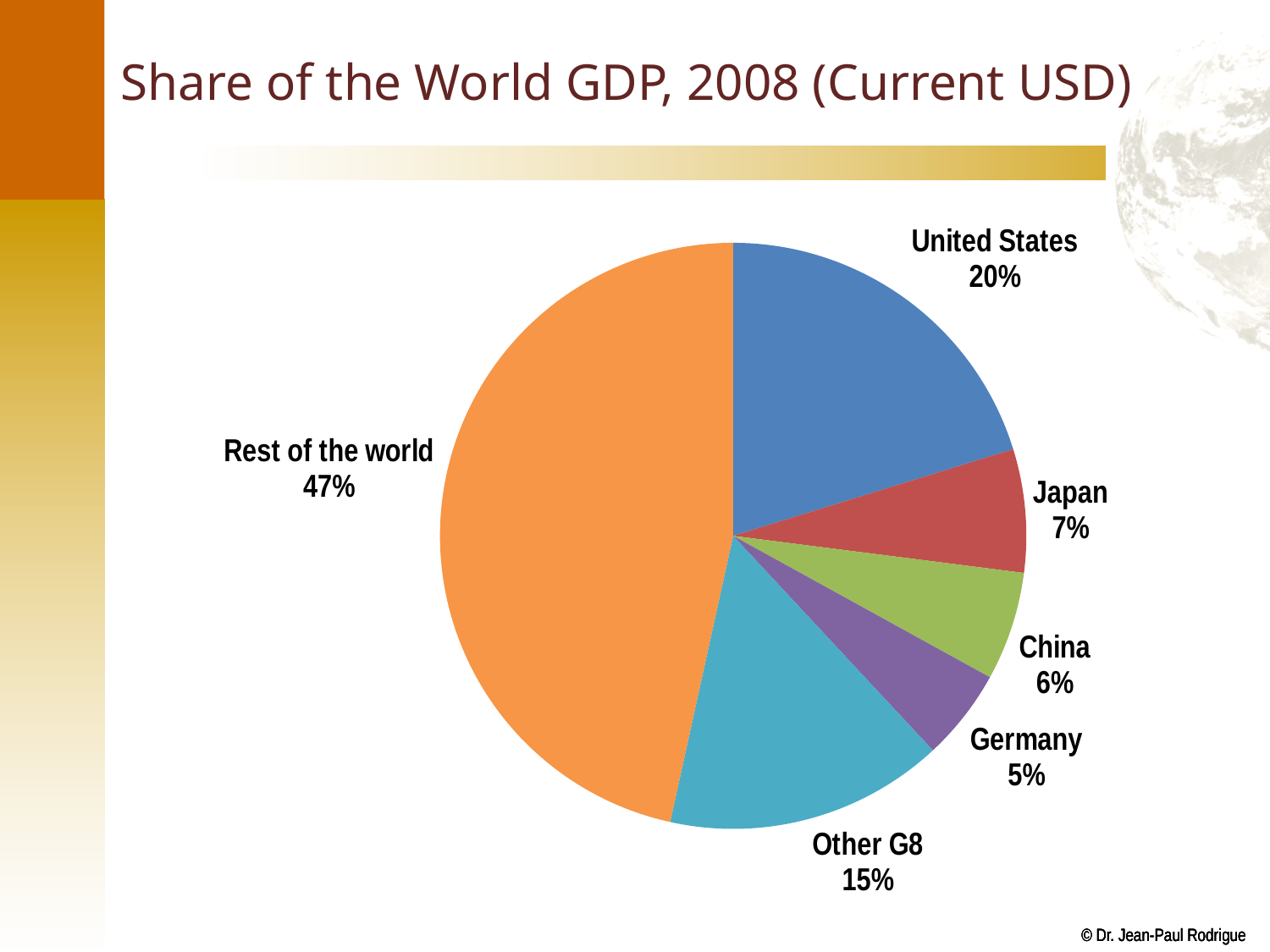
What is the combined share of the United States and Other G8? 35% What is the title of the slide? Share of the World GDP, 2008 (Current USD) What kind of chart is shown on the slide? pie chart What share of world GDP does Germany have? 5% What share of world GDP does Japan have? 7% How many slices does the pie chart have? 6 Which has a larger share of world GDP, Japan or China? Japan What is the difference between the share of the United States and the share of China? 14% Which slice of the pie is the smallest? Germany What share of world GDP is attributed to Other G8? 15% What share of world GDP does the United States have? 20% Which slice of the pie is the largest? Rest of the world